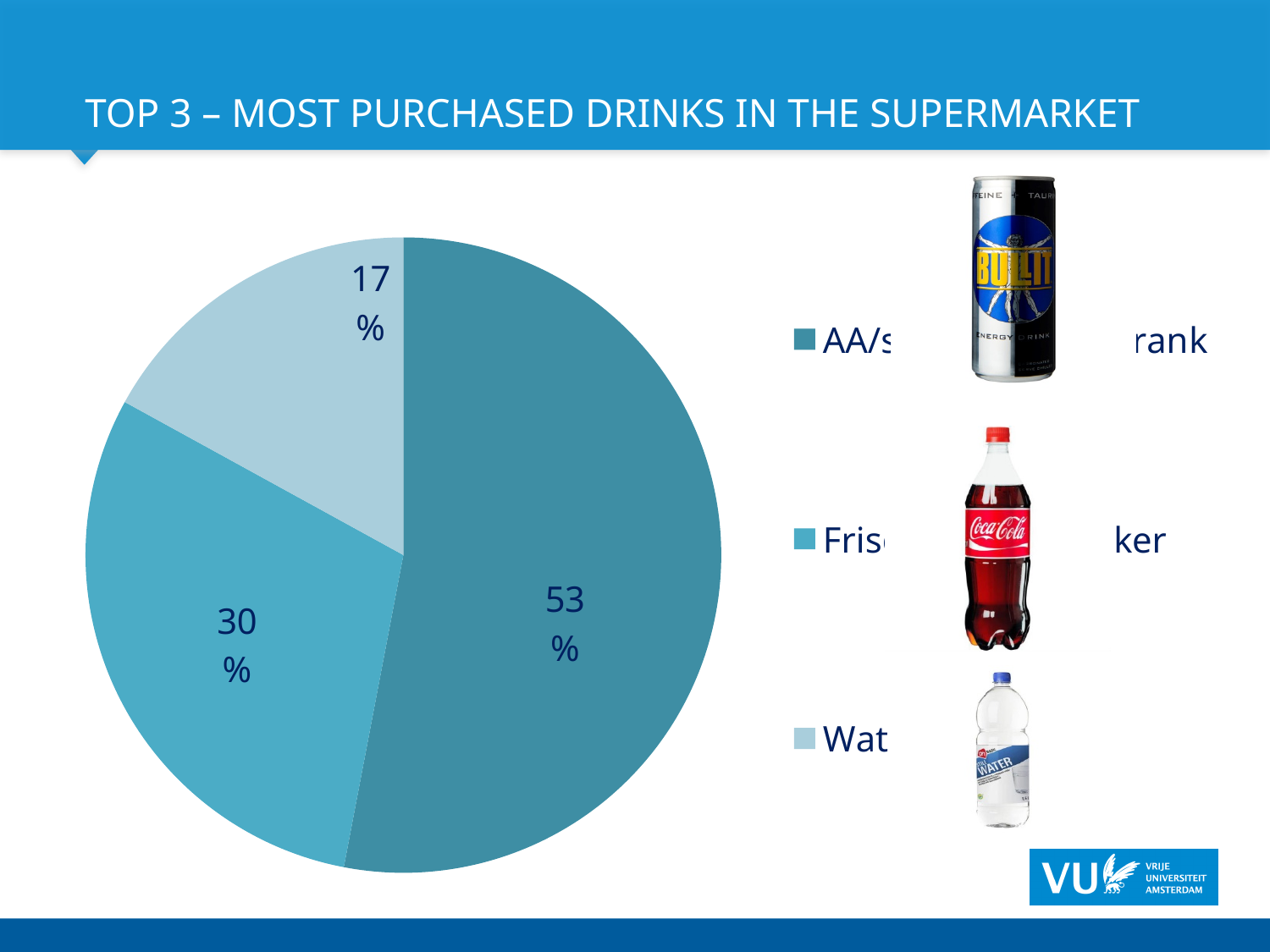
What value is shown on the lightest blue slice of the pie chart? 17% What is the difference between the 53% slice and the 30% slice? 23% What kind of chart is shown on the slide? pie chart What is the value of the largest slice in the pie chart? 53% What value is shown on the darkest teal slice of the pie chart? 53% What is the title of the slide containing the pie chart? TOP 3 – MOST PURCHASED DRINKS IN THE SUPERMARKET How many entries does the legend of the pie chart list? 3 How many slices does the pie chart have? 3 What is the value of the smallest slice in the pie chart? 17% What value is shown on the medium blue slice of the pie chart? 30% Which is larger, the medium blue slice or the lightest blue slice? the medium blue slice What is the difference between the largest and smallest slices of the pie chart? 36%